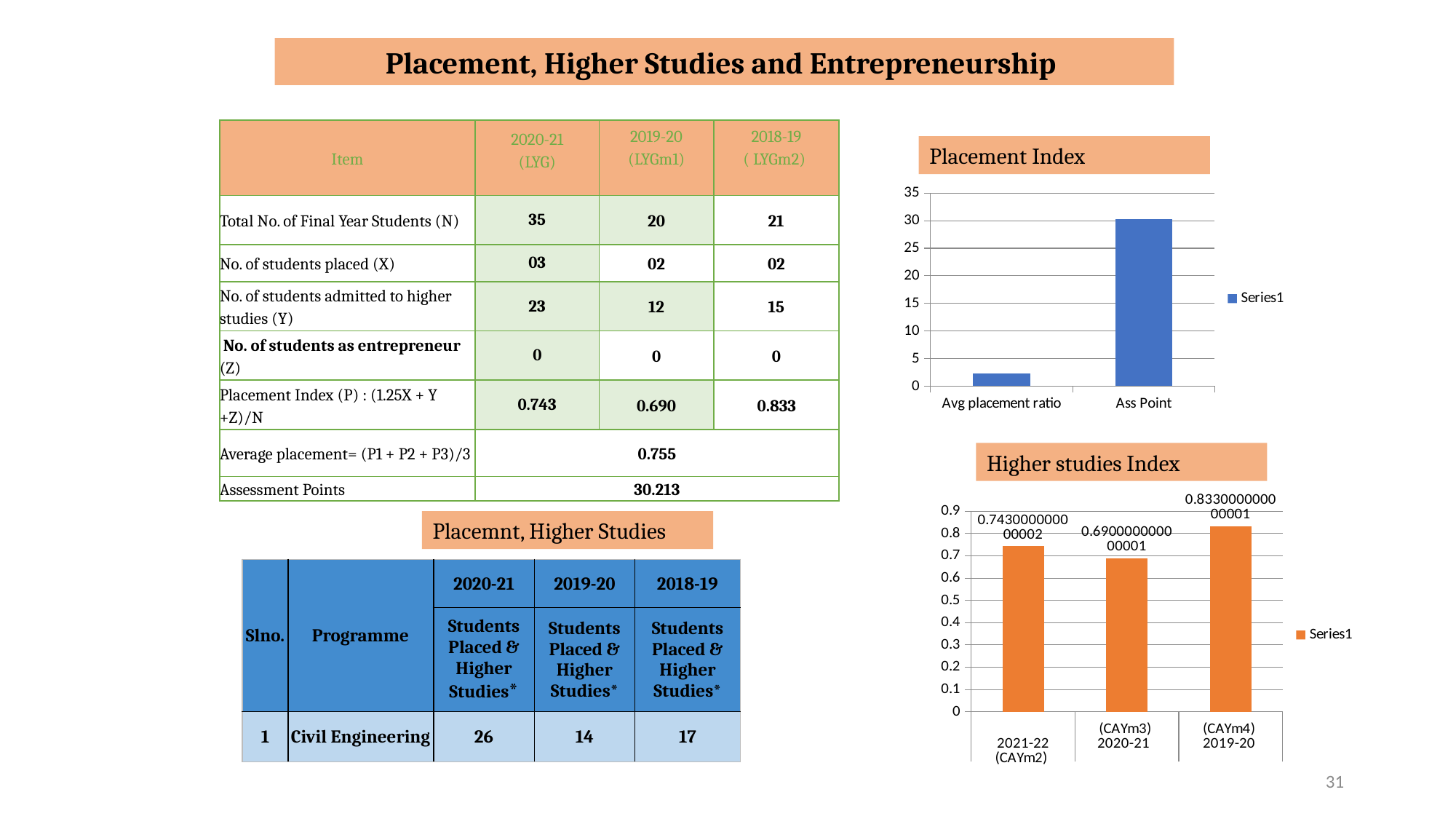
In the Higher studies Index chart, what is the value for 2021-22 (CAYm2)? 0.743000000000002 In the Placement Index chart, which category has the highest bar? Ass Point What kind of chart is the Placement Index chart? bar chart How many categories are shown on the x axis of the Placement Index chart? 2 In the Placement Index chart, is the value for Avg placement ratio greater or less than 5? less In the Higher studies Index chart, what is the value for (CAYm3) 2020-21? 0.690000000000001 In the Higher studies Index chart, which category has the lowest value? (CAYm3) 2020-21 In the Higher studies Index chart, which category has the highest value? (CAYm4) 2019-20 In the Placement Index chart, is the value for Ass Point greater or less than 25? greater In the Higher studies Index chart, what is the value for (CAYm4) 2019-20? 0.833000000000001 How many series does the legend of the Placement Index chart list? 1 In the Higher studies Index chart, which is larger: the value for 2021-22 (CAYm2) or the value for (CAYm3) 2020-21? 2021-22 (CAYm2)